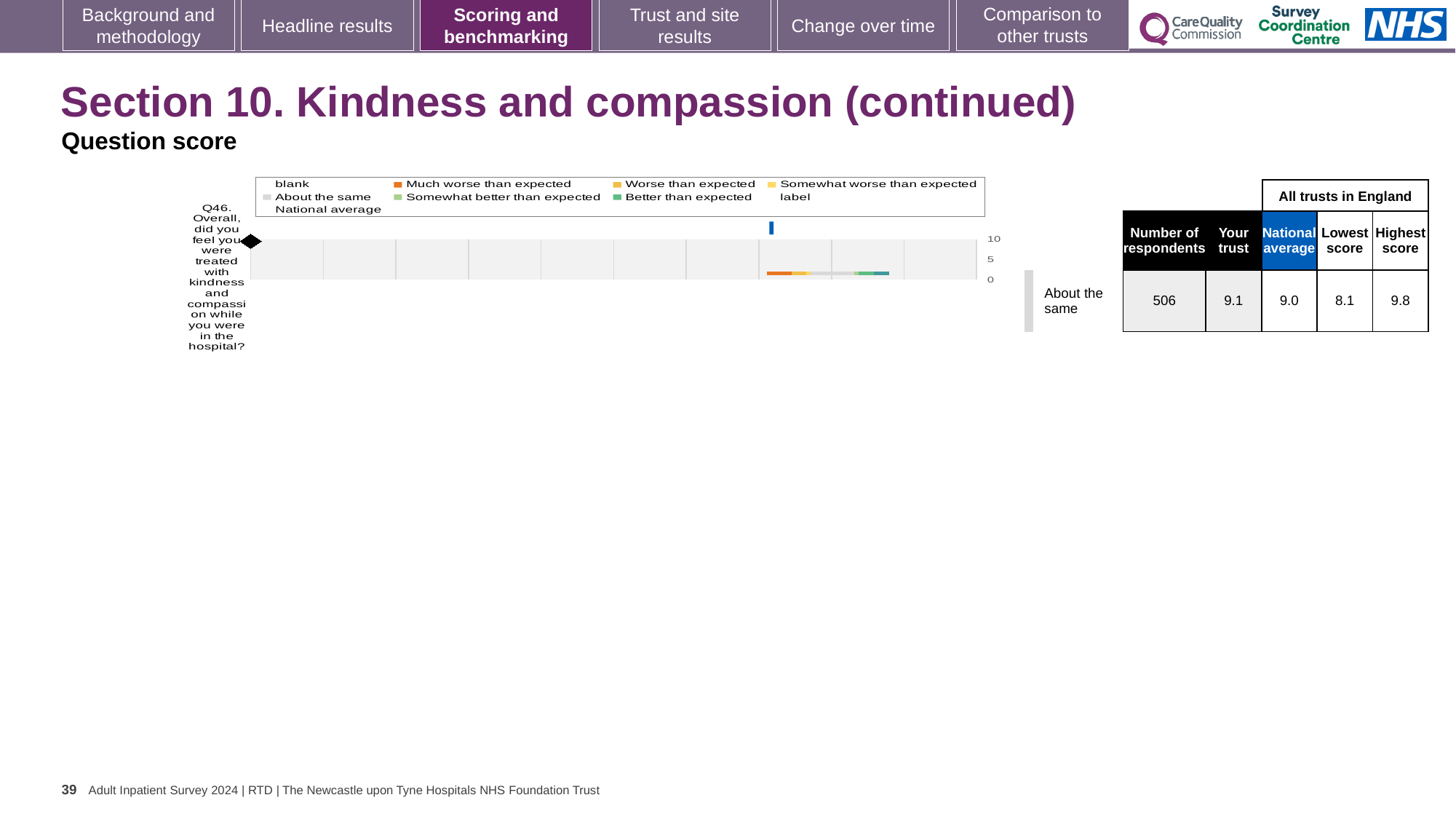
What is the Highest score among all trusts in England for Q46? 9.8 Which survey question does the chart plot? Q46. Overall, did you feel you were treated with kindness and compassion while you were in the hospital? Which legend entry is shown in dark green? Better than expected Is the Your trust score for Q46 greater or less than 5? greater What is the difference between the Highest score and the Lowest score for Q46? 1.7 What is the score for Your trust for Q46? 9.1 What kind of chart is shown on the slide? bar chart How many respondents answered Q46? 506 What is the National average score for Q46? 9.0 What is the difference between the Your trust score and the National average for Q46? 0.1 What is the Lowest score among all trusts in England for Q46? 8.1 Which is larger for Q46, the Your trust score or the National average? Your trust